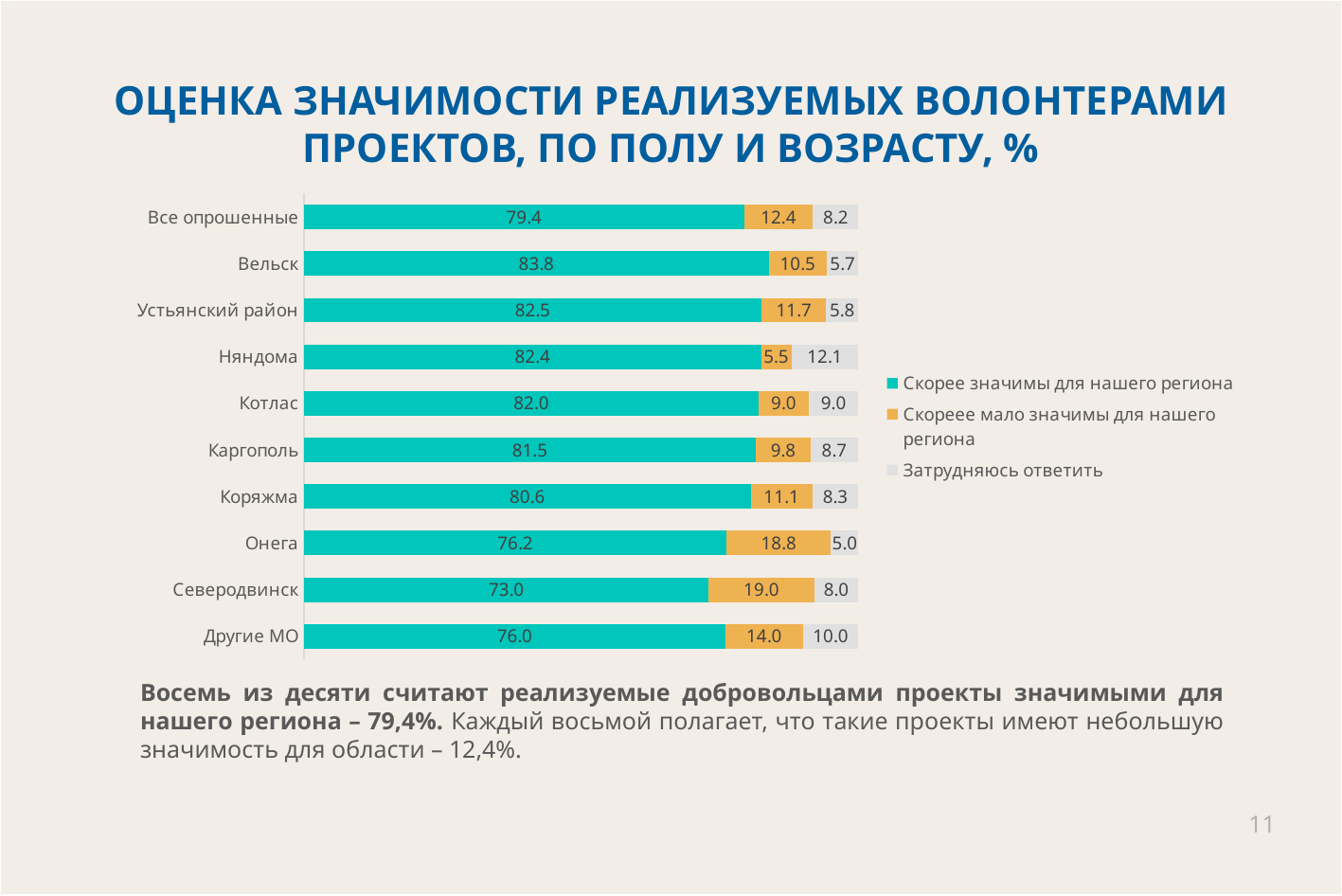
Сколько рядов данных перечислено в легенде? 3 В какой категории самое высокое значение «Скорее значимы для нашего региона»? Вельск В какой категории самое низкое значение «Скорее мало значимы для нашего региона»? Няндома В какой категории самое низкое значение «Скорее значимы для нашего региона»? Северодвинск Где значение «Скорее мало значимы для нашего региона» больше: в Онеге или в Коряжме? Онега Какое значение «Скорее значимы для нашего региона» у категории «Все опрошенные»? 79.4 Какова сумма трёх значений для Вельска? 100.0 Какое значение «Скорее мало значимы для нашего региона» у Северодвинска? 19.0 На сколько значение «Скорее значимы для нашего региона» у Вельска больше, чем у Северодвинска? 10.8 Сколько категорий показано на диаграмме? 10 Какого типа эта диаграмма? Столбчатая (линейчатая) диаграмма с накоплением Какое значение «Затрудняюсь ответить» у Няндомы? 12.1